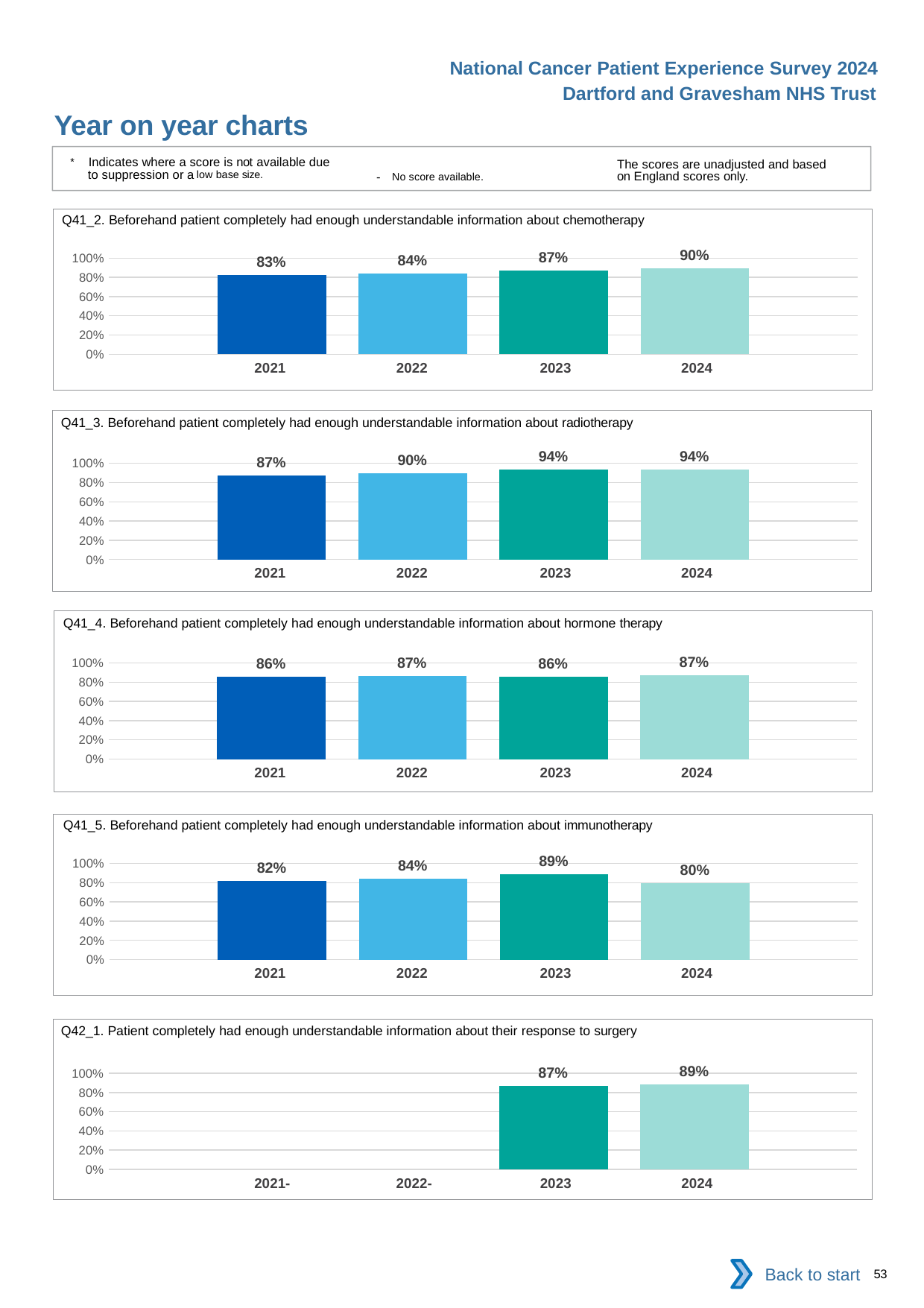
In the Q41_3 chart about radiotherapy, do the values rise or fall from 2021 to 2023? rise What kind of chart is the Q42_1 chart about response to surgery? bar chart In the Q42_1 chart about response to surgery, how many years have bars plotted? 2 In the Q41_2 chart about chemotherapy, which year has the lowest value? 2021 In the Q41_5 chart about immunotherapy, which is larger, the value for 2021 or the value for 2023? 2023 In the Q41_3 chart about radiotherapy, what is the value for 2021? 87% In the Q41_3 chart about radiotherapy, what is the difference between the 2023 and 2021 values? 7% In the Q41_5 chart about immunotherapy, what is the value for 2024? 80% In the Q41_4 chart about hormone therapy, what is the value for 2022? 87% In the Q41_5 chart about immunotherapy, which year has the highest value? 2023 In the Q41_2 chart about chemotherapy, what is the value for 2024? 90% In the Q41_4 chart about hormone therapy, how many years have bars plotted? 4